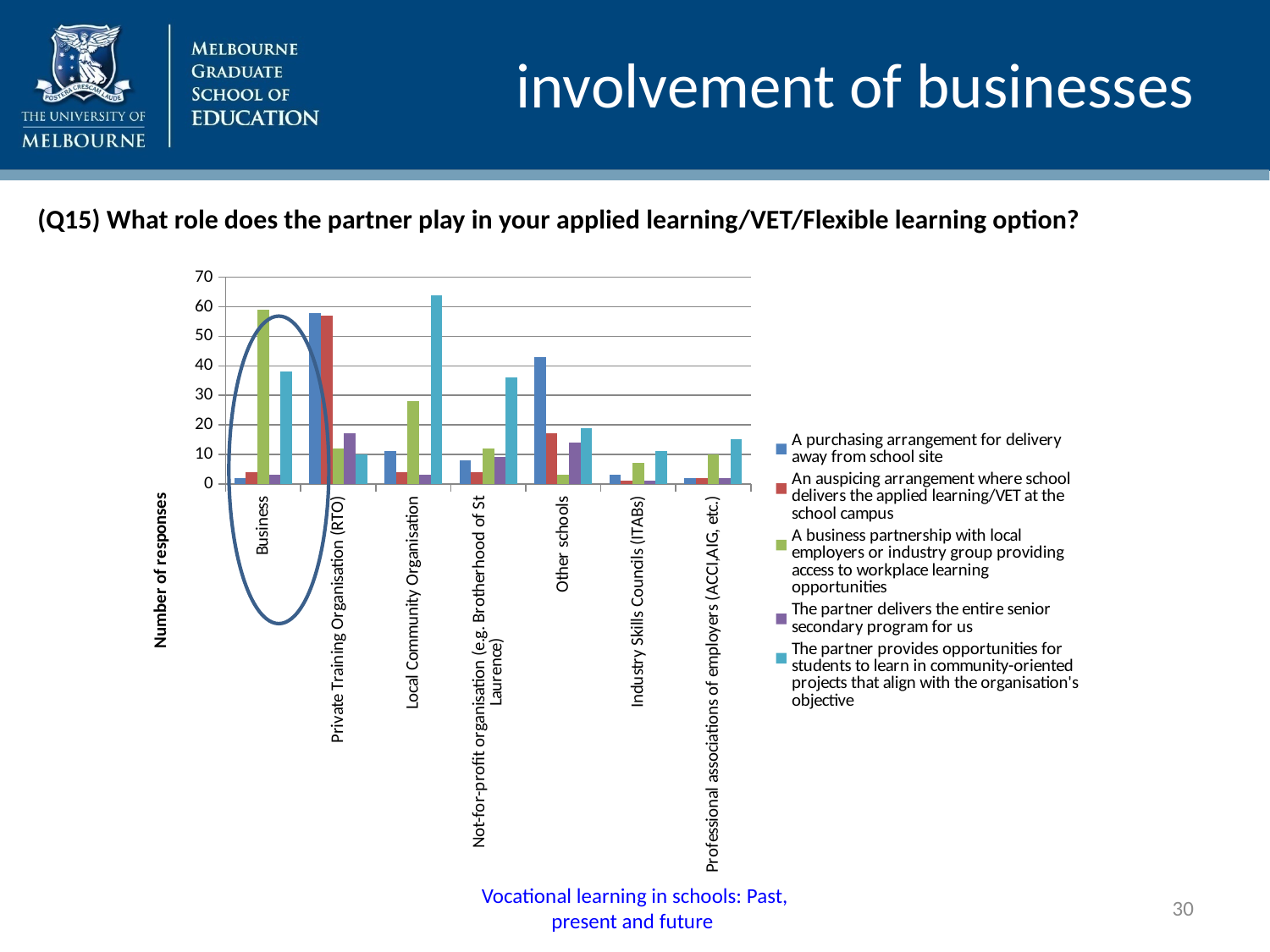
Is the value for 'The partner provides opportunities for students to learn in community-oriented projects that align with the organisation's objective' in the Local Community Organisation category greater or less than 60? greater How many partner categories are shown along the x axis of the chart? 7 Is the value for 'A business partnership with local employers or industry group providing access to workplace learning opportunities' in the Business category greater or less than 50? greater How many series does the chart's legend list? 5 For the Not-for-profit organisation category, which series has the larger value: 'The partner provides opportunities for students to learn in community-oriented projects that align with the organisation's objective' or 'A purchasing arrangement for delivery away from school site'? The partner provides opportunities for students to learn in community-oriented projects that align with the organisation's objective Which category has the tallest bar for 'The partner provides opportunities for students to learn in community-oriented projects that align with the organisation's objective'? Local Community Organisation Is the value for 'A purchasing arrangement for delivery away from school site' in the Other schools category greater or less than 40? greater Which category is circled on the chart? Business What is the label of the vertical axis of the chart? Number of responses What kind of chart is shown on the slide? bar chart Which category has the tallest bar for 'A business partnership with local employers or industry group providing access to workplace learning opportunities'? Business Which category has the tallest bar for 'A purchasing arrangement for delivery away from school site'? Private Training Organisation (RTO)